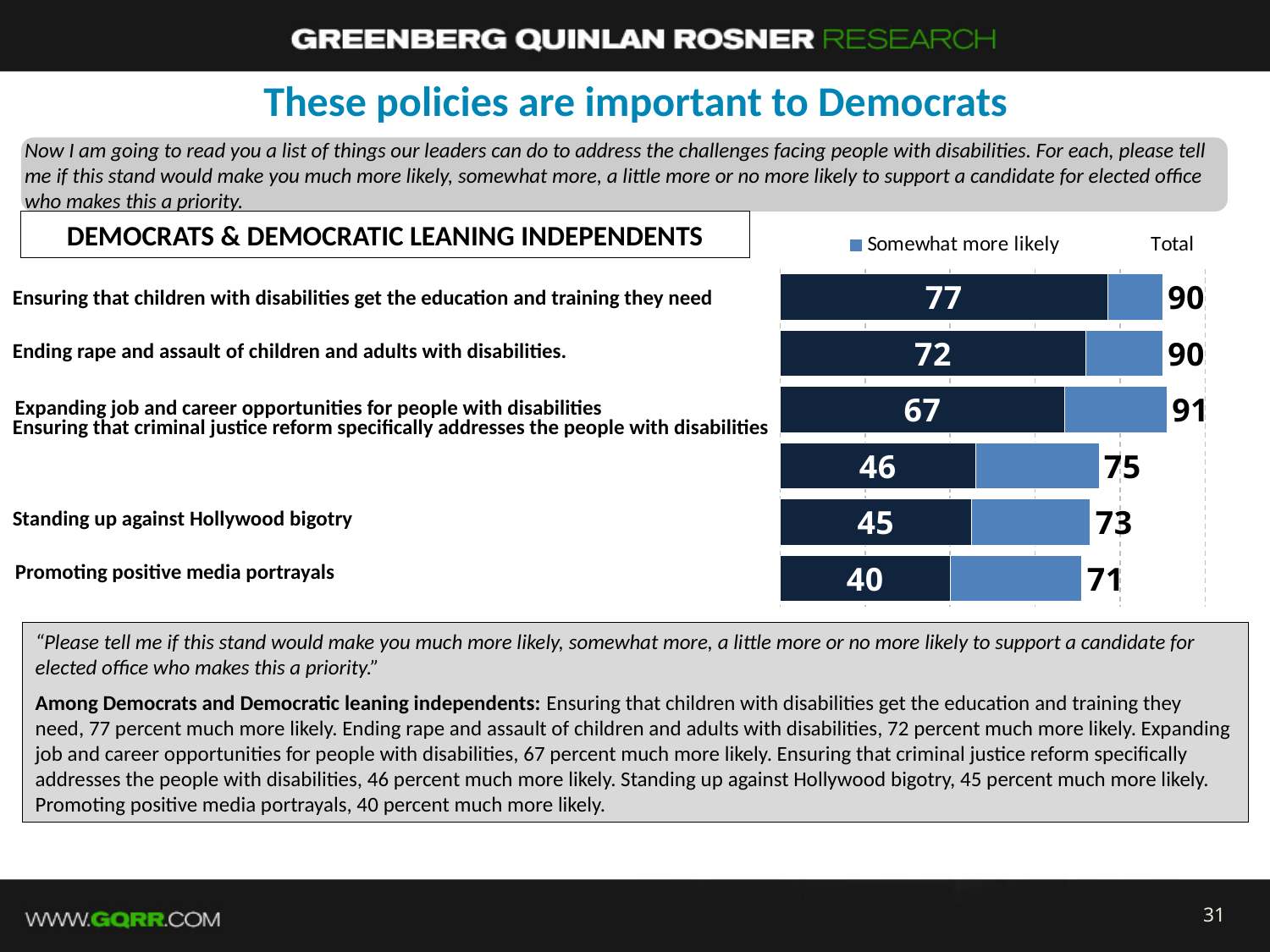
Do the 'much more likely' values rise or fall going from the top bar to the bottom bar? Fall Which policy has the highest total? Expanding job and career opportunities for people with disabilities What kind of chart is shown on the slide? Stacked bar chart What is the difference between the 'much more likely' values for 'Ensuring that children with disabilities get the education and training they need' and 'Ending rape and assault of children and adults with disabilities'? 5 How many policies are plotted in the chart? 6 What is the total shown for 'Expanding job and career opportunities for people with disabilities'? 91 What is the difference between the total and the 'much more likely' value for 'Promoting positive media portrayals'? 31 What is the 'much more likely' value (dark navy segment) for 'Ensuring that children with disabilities get the education and training they need'? 77 Which has a higher total: 'Ensuring that criminal justice reform specifically addresses the people with disabilities' or 'Standing up against Hollywood bigotry'? Ensuring that criminal justice reform specifically addresses the people with disabilities Which policy has the lowest 'much more likely' value (dark navy segment)? Promoting positive media portrayals What is the total shown for 'Promoting positive media portrayals'? 71 What is the 'much more likely' value (dark navy segment) for 'Standing up against Hollywood bigotry'? 45